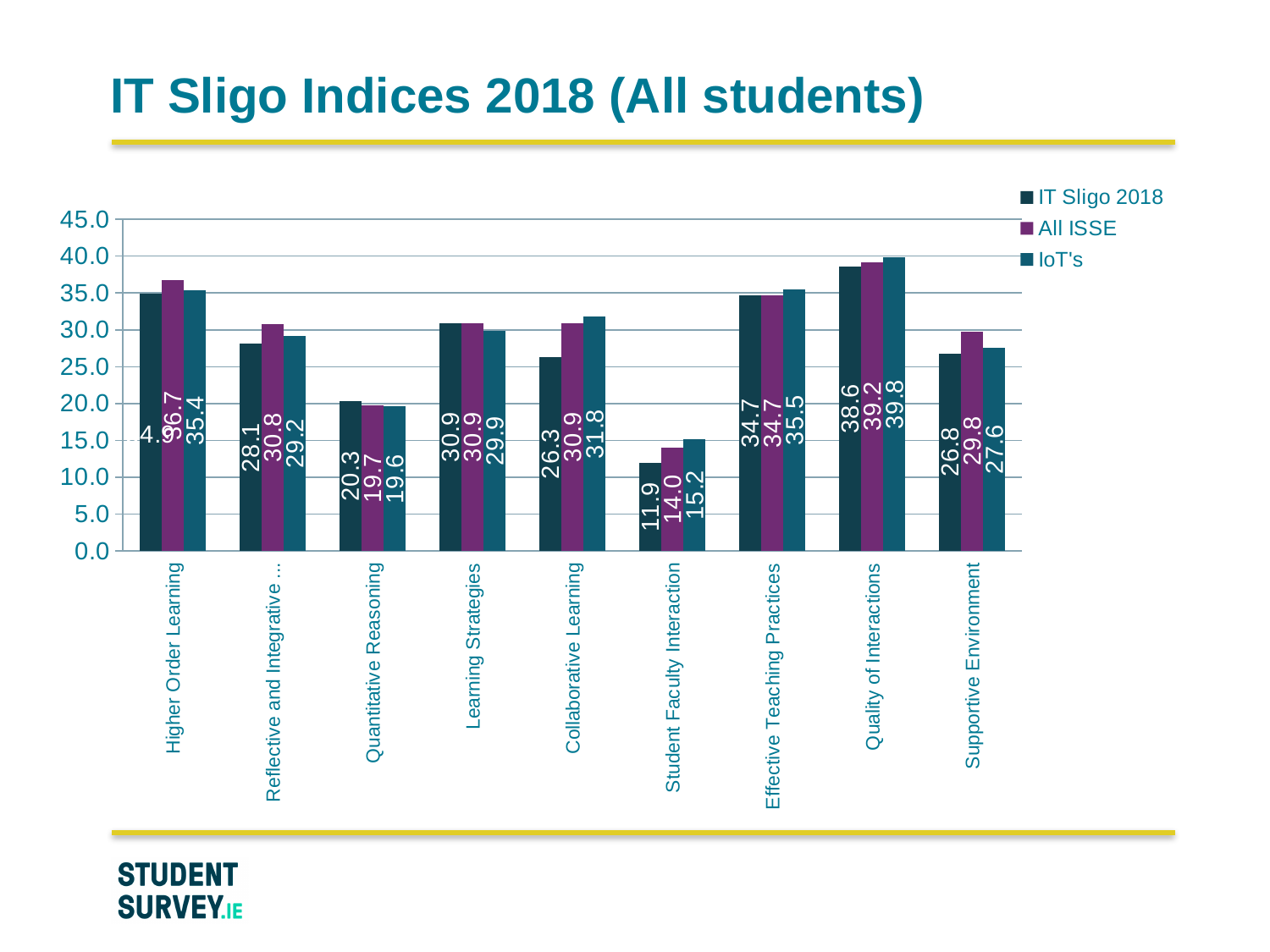
What kind of chart is shown on the slide? bar chart Which category has the highest IT Sligo 2018 value? Quality of Interactions How many series does the legend list? 3 What is the IoT's value for Quality of Interactions? 39.8 How many categories are shown on the x axis of the chart? 9 What is the IT Sligo 2018 value for Student Faculty Interaction? 11.9 What is the title of the slide? IT Sligo Indices 2018 (All students) For Supportive Environment, which is larger: the All ISSE value or the IoT's value? All ISSE For Collaborative Learning, what is the difference between the IoT's value and the IT Sligo 2018 value? 5.5 Is the IT Sligo 2018 value for Effective Teaching Practices greater or less than 30.0? greater What is the All ISSE value for Collaborative Learning? 30.9 Which category has the lowest IoT's value? Student Faculty Interaction